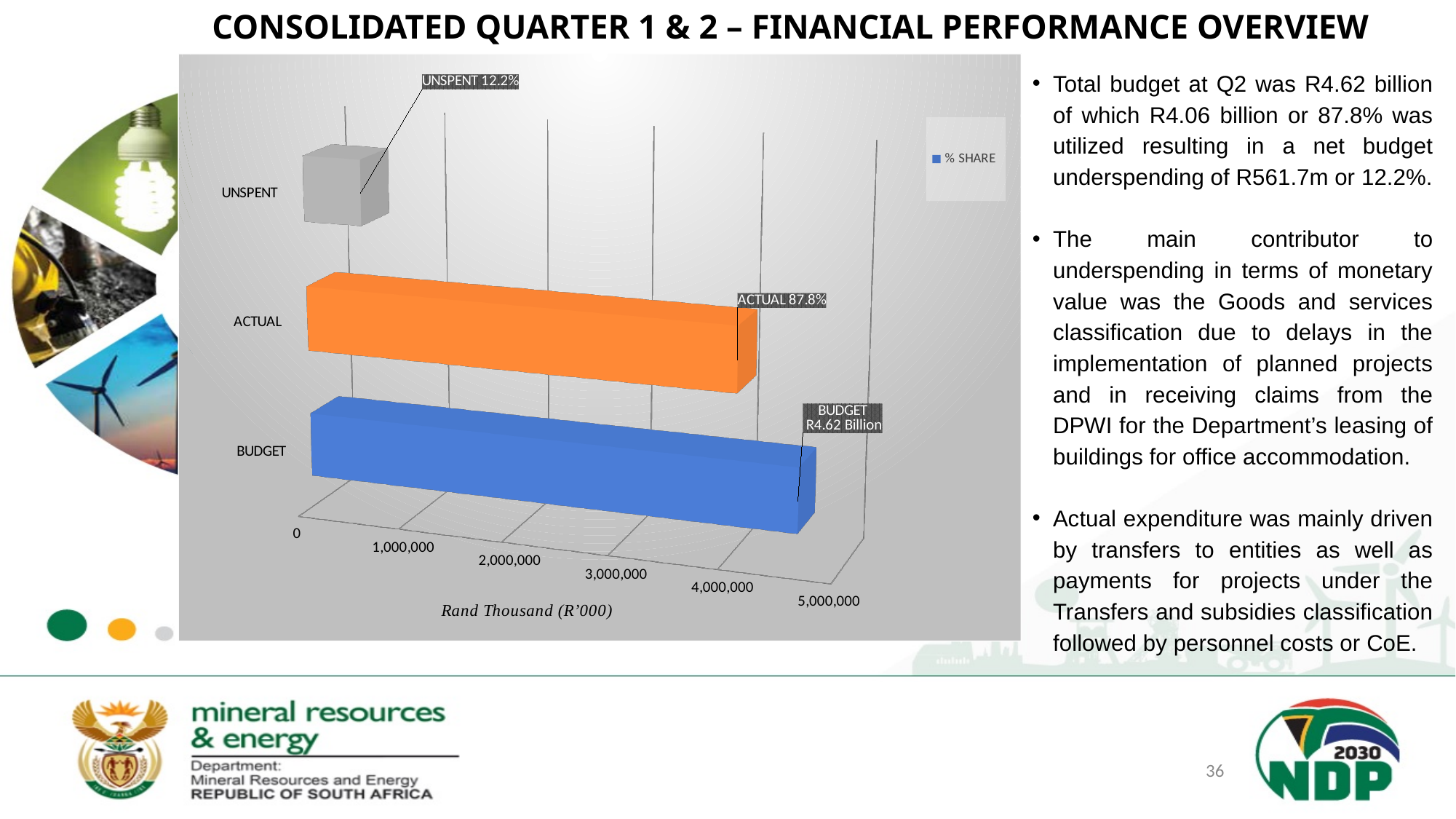
How many series does the chart legend list? 1 Which category has the longest bar in the chart? BUDGET How many categories are plotted in the chart? 3 What percentage is shown on the data label for ACTUAL? 87.8% What value is shown on the data label for BUDGET? R4.62 Billion What percentage is shown on the data label for UNSPENT? 12.2% What is the difference in percentage points between the ACTUAL label (87.8%) and the UNSPENT label (12.2%)? 75.6% Is the value for UNSPENT greater or less than 1,000,000? less Which bar is longer, ACTUAL or UNSPENT? ACTUAL Is the value for ACTUAL greater or less than 3,000,000? greater What kind of chart is shown on the slide? bar chart Which category has the shortest bar in the chart? UNSPENT